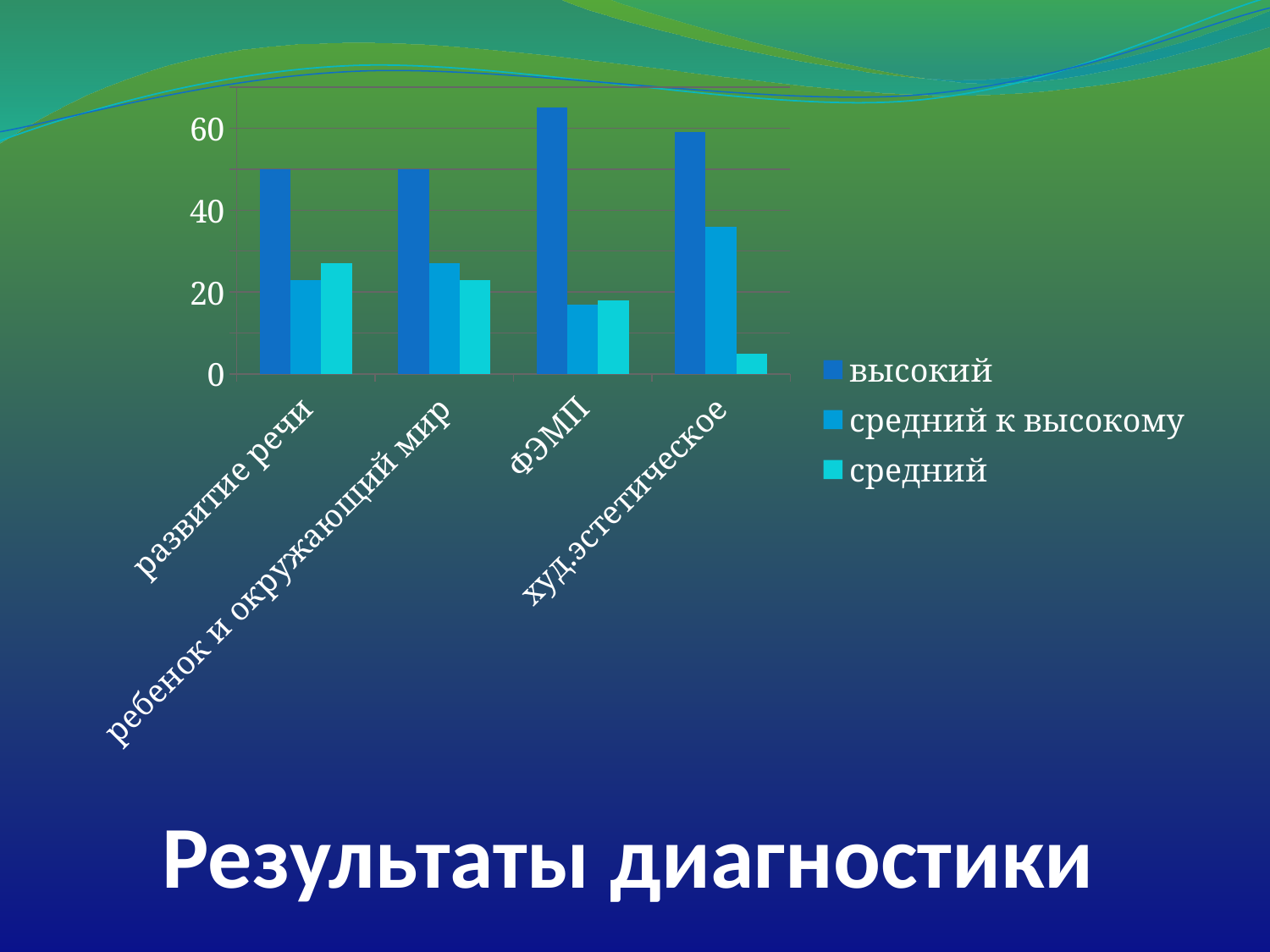
Which is larger: the 'средний к высокому' value for 'худ.эстетическое' or for 'ФЭМП'? худ.эстетическое What kind of chart is shown on the slide? bar chart How many categories are shown on the x axis of the chart? 4 Which category has the highest value for the series 'высокий'? ФЭМП Is the value for 'высокий' in the category 'ФЭМП' greater or less than 60? greater Is the value for 'высокий' in the category 'развитие речи' greater or less than 40? greater How many series does the chart's legend list? 3 What is the title shown below the chart on the slide? Результаты диагностики Is the value for 'средний к высокому' in the category 'худ.эстетическое' greater or less than 20? greater Which category has the lowest value for the series 'средний'? худ.эстетическое Which is larger: the 'высокий' value for 'ФЭМП' or the 'высокий' value for 'худ.эстетическое'? ФЭМП